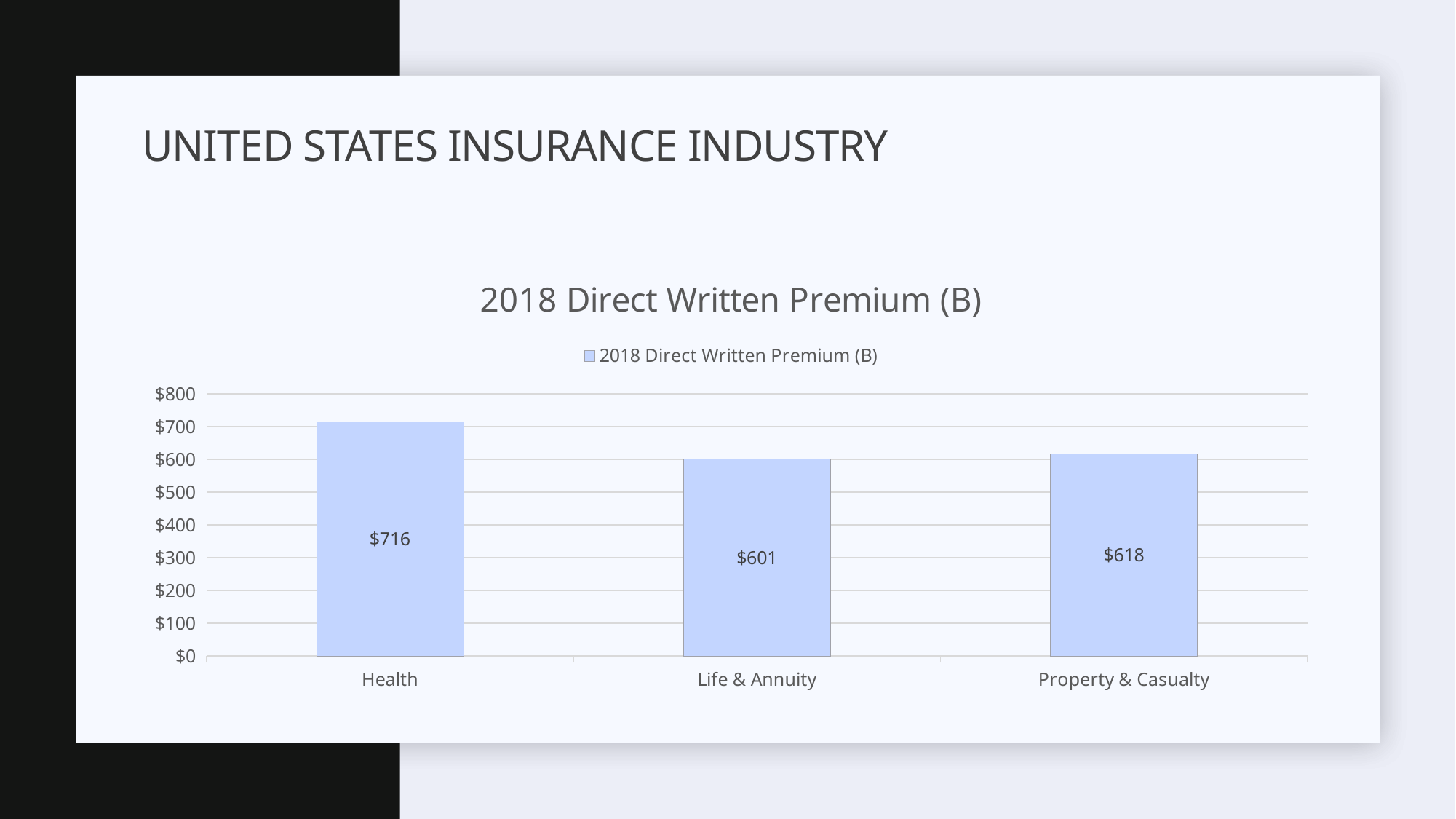
What is the 2018 Direct Written Premium (B) for Health? $716 What is the 2018 Direct Written Premium (B) for Property & Casualty? $618 What is the difference between the Health and Life & Annuity values? $115 What is the 2018 Direct Written Premium (B) for Life & Annuity? $601 How many categories are shown on the x axis? 3 What kind of chart is shown on the slide? Bar chart Is the value for Health greater or less than $700? greater Which category has the lowest 2018 Direct Written Premium? Life & Annuity What is the difference between the Property & Casualty and Life & Annuity values? $17 What is the title of the chart? 2018 Direct Written Premium (B) Which is larger, the value for Health or the value for Property & Casualty? Health Which category has the highest 2018 Direct Written Premium? Health